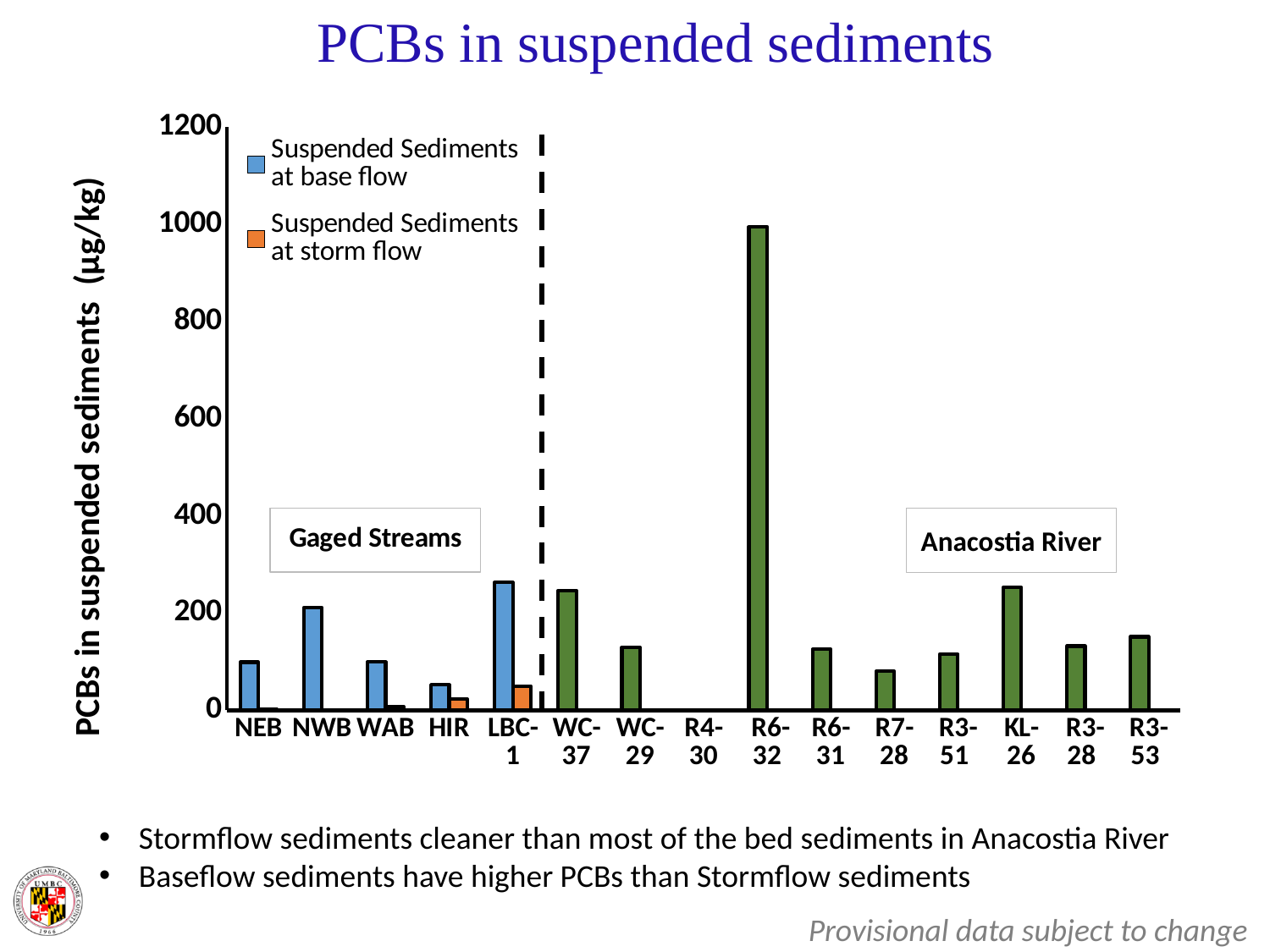
Among the gaged streams, which site has the lowest base flow value? HIR How many series does the legend list? 2 Is the value for R6-32 greater or less than 800? greater Is the base flow value for NEB greater or less than 200? less How many site categories are shown along the x axis? 15 What is the title of the chart? PCBs in suspended sediments Is the value for R7-28 greater or less than 200? less What kind of chart is shown on the slide? bar chart Which has a larger base flow value, NWB or NEB? NWB At LBC-1, which is larger: the base flow value or the storm flow value? base flow Which site has the highest PCB value in the chart? R6-32